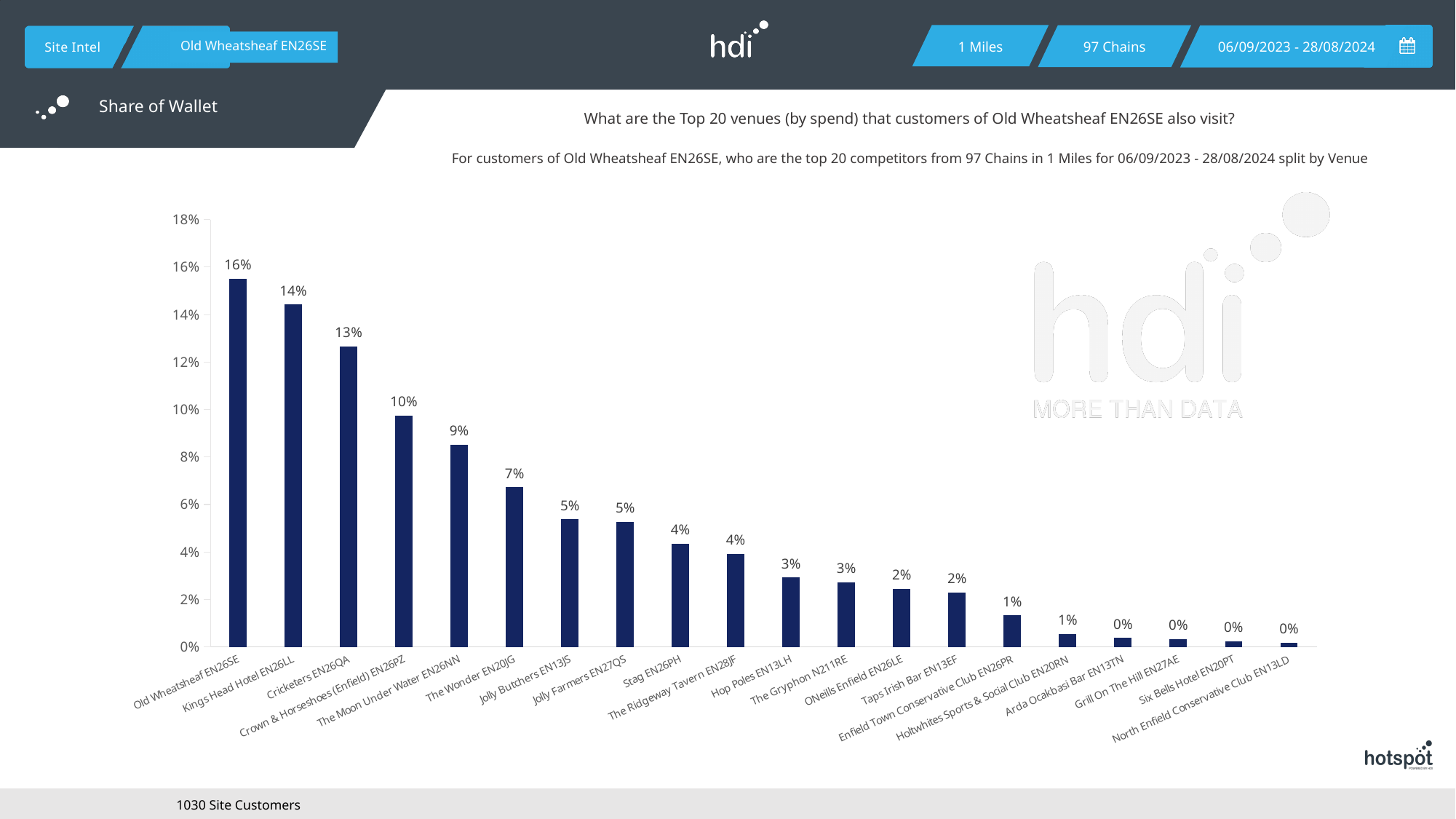
What is the difference between the values for Old Wheatsheaf EN26SE and Kings Head Hotel EN26LL? 2% Which is larger, the value for Cricketers EN26QA or the value for The Wonder EN20JG? Cricketers EN26QA What is the value for Old Wheatsheaf EN26SE? 16% What is the value for Hop Poles EN13LH? 3% What is the value for Cricketers EN26QA? 13% How many venues are shown on the chart? 20 Which venue has the highest value? Old Wheatsheaf EN26SE Do the values rise or fall from left to right along the x axis? fall What type of chart is shown on the slide? bar chart What is the value for Taps Irish Bar EN13EF? 2% What is the value for The Wonder EN20JG? 7% Is the value for The Moon Under Water EN26NN greater or less than 8%? greater